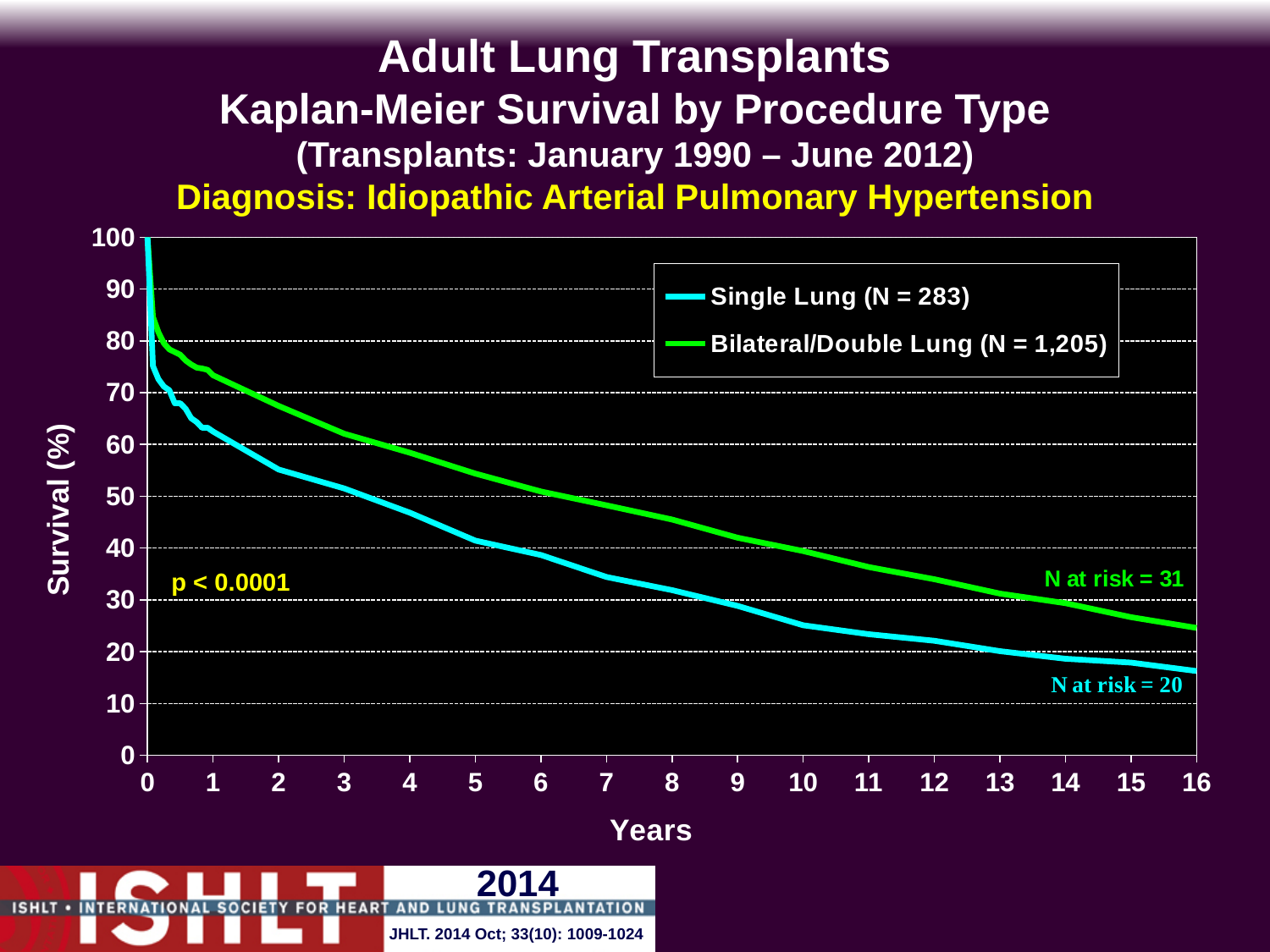
At 8 years, which curve shows higher survival, Single Lung or Bilateral/Double Lung? Bilateral/Double Lung What is the N at risk shown for the Bilateral/Double Lung curve at the right end of the chart? 31 How many series does the legend list? 2 What is the N for the Bilateral/Double Lung series shown in the legend? 1,205 What p-value is printed on the chart? p < 0.0001 What kind of chart is shown on the slide? line chart Is the Single Lung survival at 10 years greater or less than 30%? less What is the N for the Single Lung series shown in the legend? 283 Do the survival curves rise or fall as years increase along the x axis? fall What is the N at risk shown for the Single Lung curve at the right end of the chart? 20 Is the Bilateral/Double Lung survival at 5 years greater or less than 50%? greater What is the label of the y axis? Survival (%)